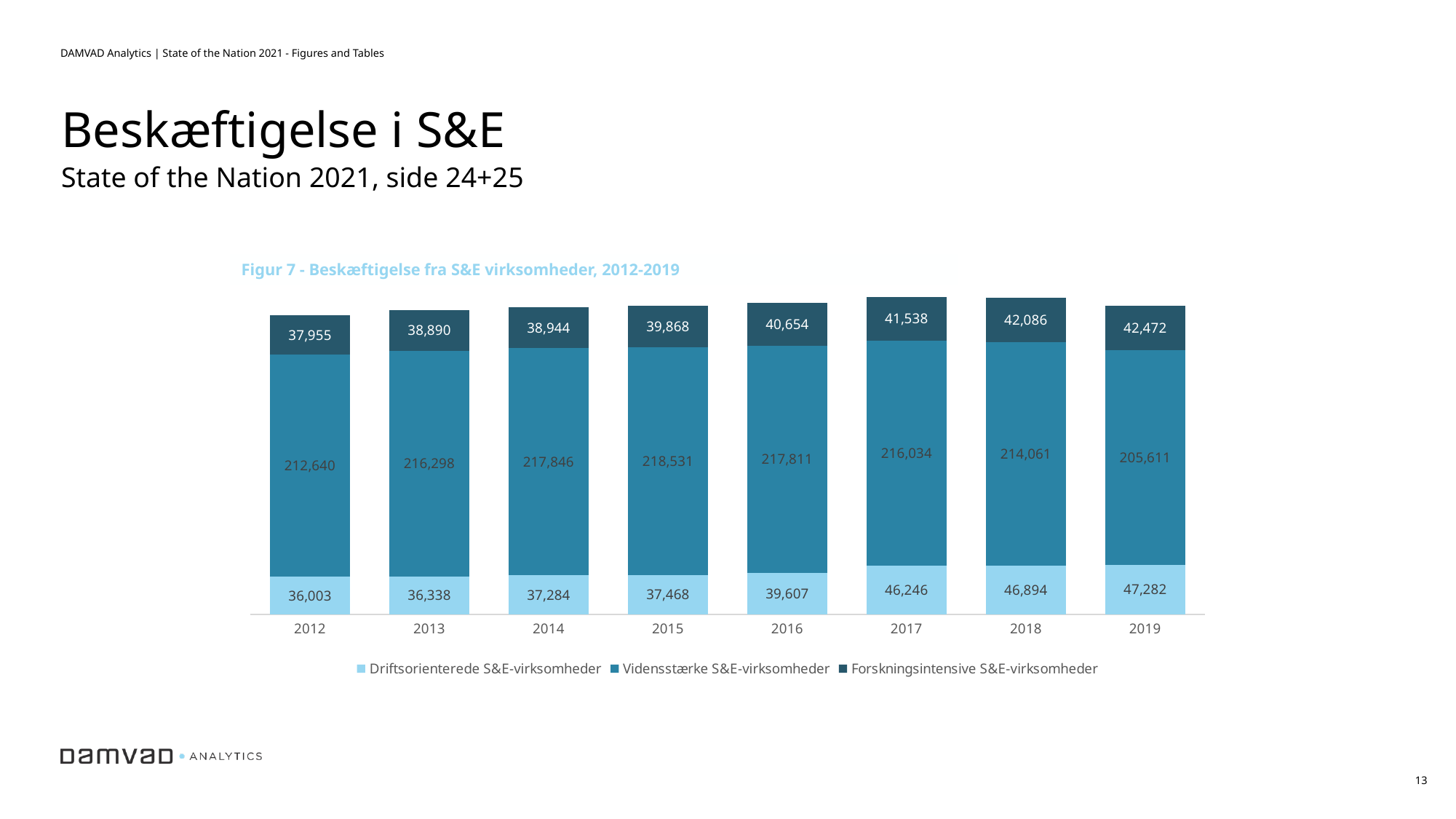
What is the total of the stacked bar for 2012? 286,598 Which is larger: Driftsorienterede S&E-virksomheder in 2016 or Forskningsintensive S&E-virksomheder in 2016? Forskningsintensive S&E-virksomheder In which year is the value for Vidensstærke S&E-virksomheder highest? 2015 In which year is the value for Driftsorienterede S&E-virksomheder highest? 2019 What is the value for Forskningsintensive S&E-virksomheder in 2019? 42,472 How many series does the legend list? 3 How many years are shown on the x axis? 8 Does the value for Forskningsintensive S&E-virksomheder rise or fall from 2012 to 2019? rise In which year is the value for Vidensstærke S&E-virksomheder lowest? 2019 What is the value for Driftsorienterede S&E-virksomheder in 2017? 46,246 What is the difference between the Forskningsintensive S&E-virksomheder values in 2019 and 2012? 4,517 What is the value for Vidensstærke S&E-virksomheder in 2015? 218,531